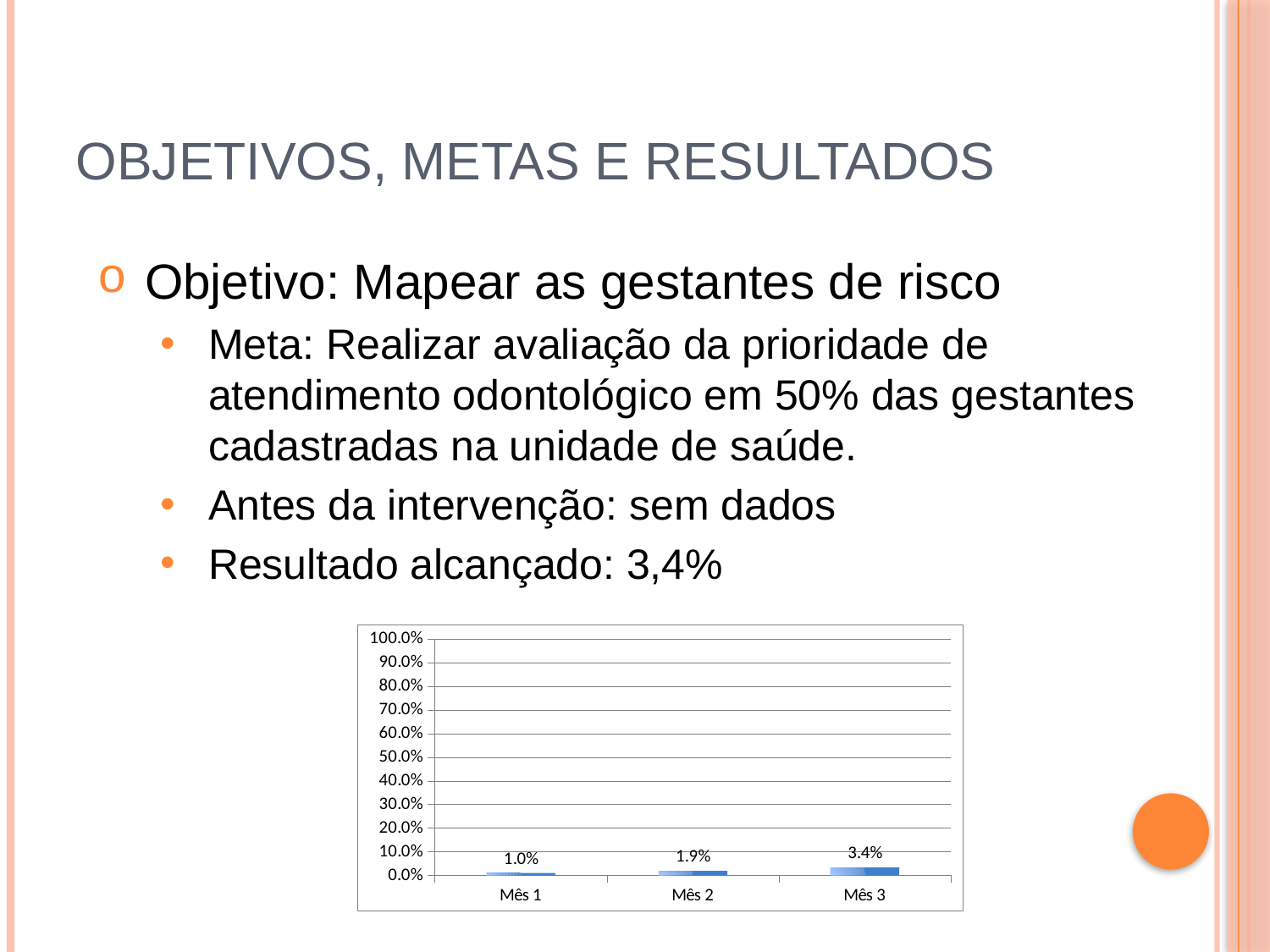
Which is larger, the value for Mês 2 or the value for Mês 3? Mês 3 Which month has the lowest value? Mês 1 How many categories are shown on the x axis? 3 Do the values rise or fall from Mês 1 to Mês 3? rise What kind of chart is shown on the slide? bar chart What is the value for Mês 1? 1.0% What is the difference between the values for Mês 2 and Mês 1? 0.9% Which month has the highest value? Mês 3 What is the value for Mês 3? 3.4% Is the value for Mês 3 greater or less than 10.0%? less What is the value for Mês 2? 1.9% What is the difference between the values for Mês 3 and Mês 1? 2.4%